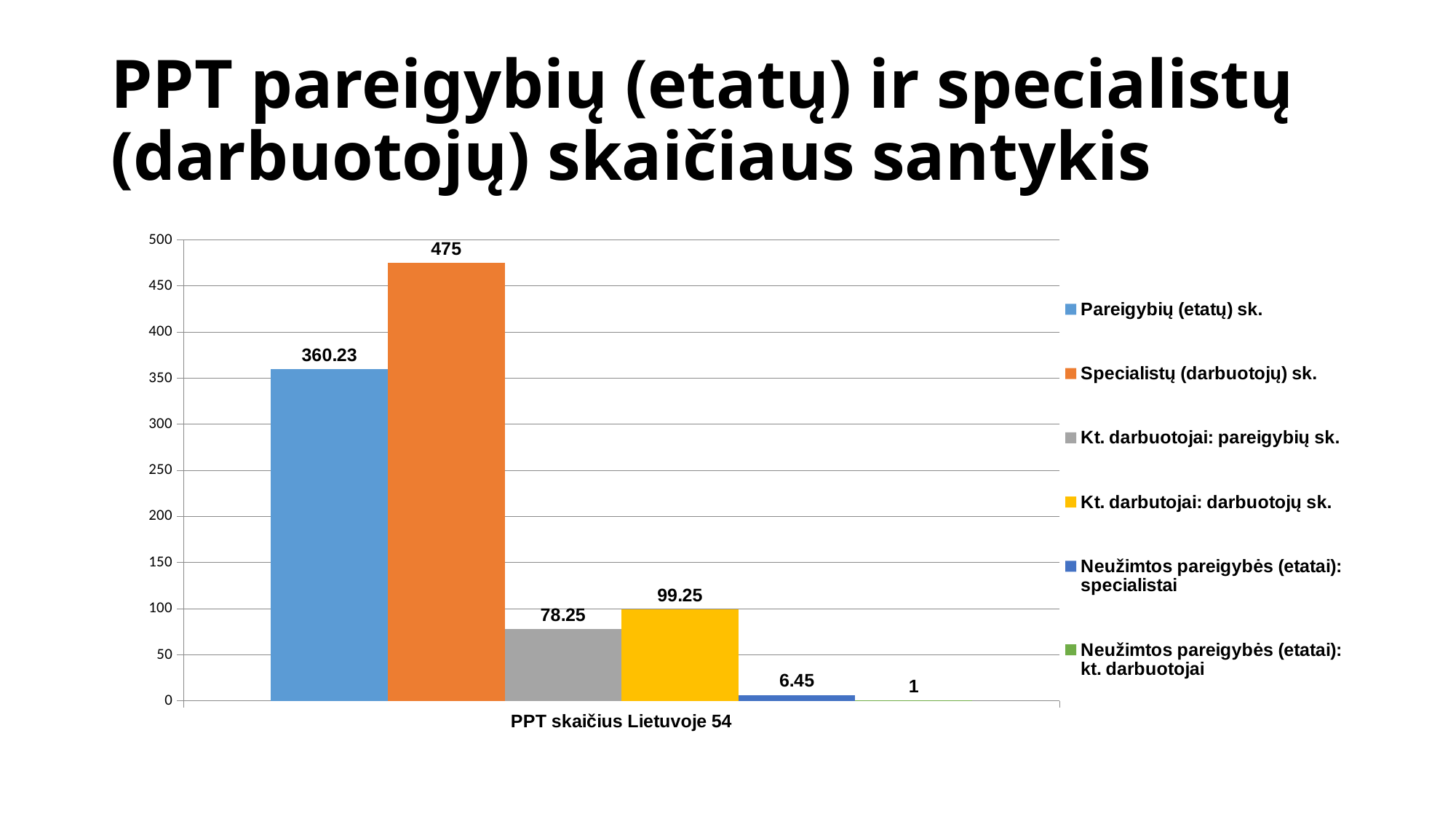
What is the value for Pareigybių (etatų) sk.? 360.23 How many series does the legend list? 6 Which series has the lowest value? Neužimtos pareigybės (etatai): kt. darbuotojai What is the difference between Specialistų (darbuotojų) sk. and Pareigybių (etatų) sk.? 114.77 What kind of chart is shown on the slide? bar chart What is the value for Neužimtos pareigybės (etatai): specialistai? 6.45 Which is larger: Kt. darbutojai: darbuotojų sk. or Kt. darbuotojai: pareigybių sk.? Kt. darbutojai: darbuotojų sk. What is the value for Specialistų (darbuotojų) sk.? 475 Which series has the highest value? Specialistų (darbuotojų) sk. Is the value for Pareigybių (etatų) sk. greater or less than 350? greater What is the value for Kt. darbuotojai: pareigybių sk.? 78.25 What is the category label shown on the x axis? PPT skaičius Lietuvoje 54